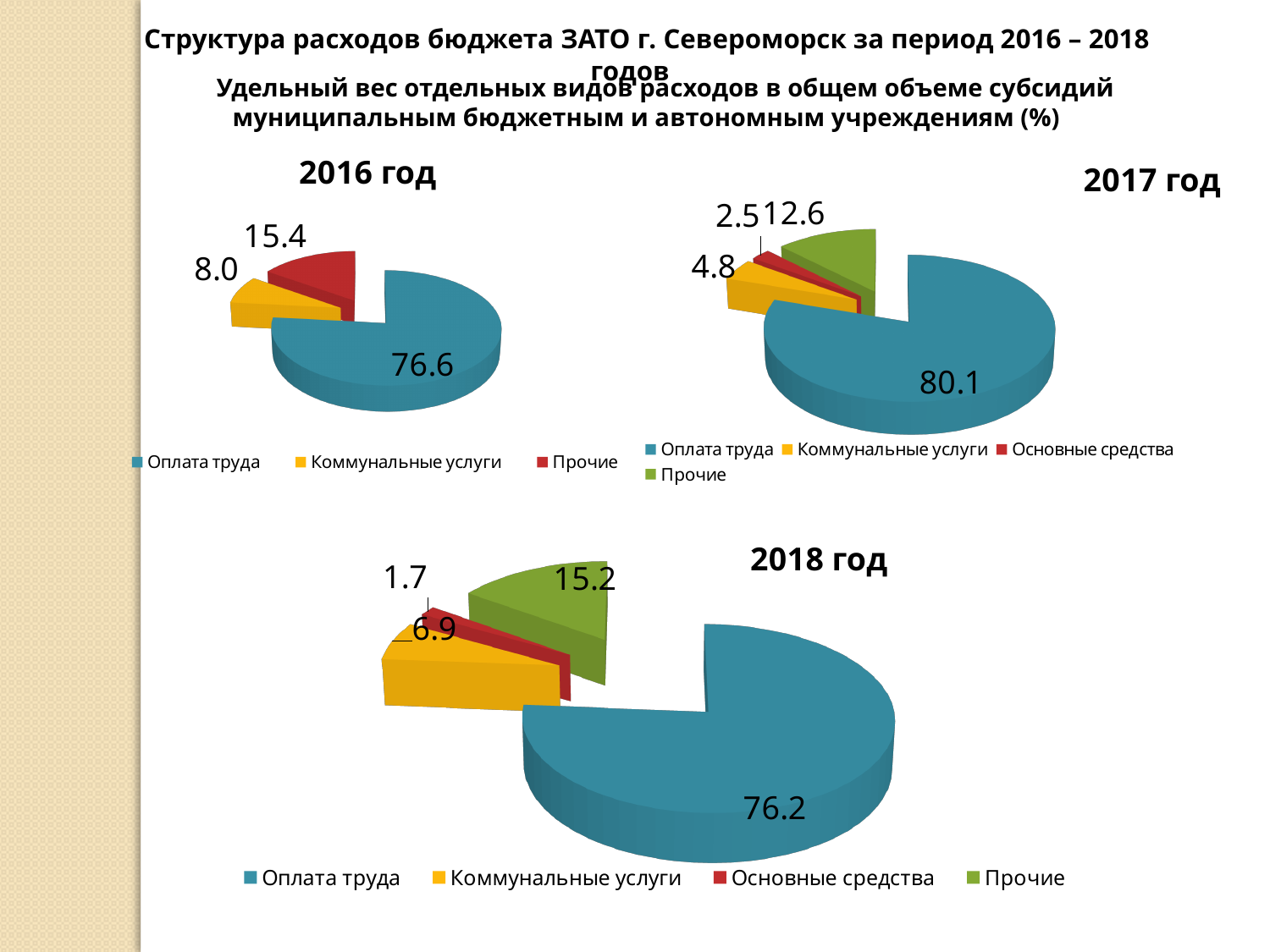
In the 2018 год pie chart, what is the value for Основные средства? 1.7 How many categories does the legend of the 2018 год pie chart list? 4 In the 2016 год pie chart, what is the difference between Прочие and Коммунальные услуги? 7.4 In the 2016 год pie chart, what is the value for Коммунальные услуги? 8.0 In the 2017 год pie chart, what is the value for Коммунальные услуги? 4.8 In the 2017 год pie chart, which category has the largest slice? Оплата труда In the 2017 год pie chart, what is the value for Оплата труда? 80.1 In the 2016 год pie chart, what is the value for Прочие? 15.4 In the 2018 год pie chart, what is the value for Прочие? 15.2 In the 2018 год pie chart, which category has the smallest slice? Основные средства What type of chart is used for the 2016 год data? Pie chart In the 2016 год pie chart, what is the value for Оплата труда? 76.6